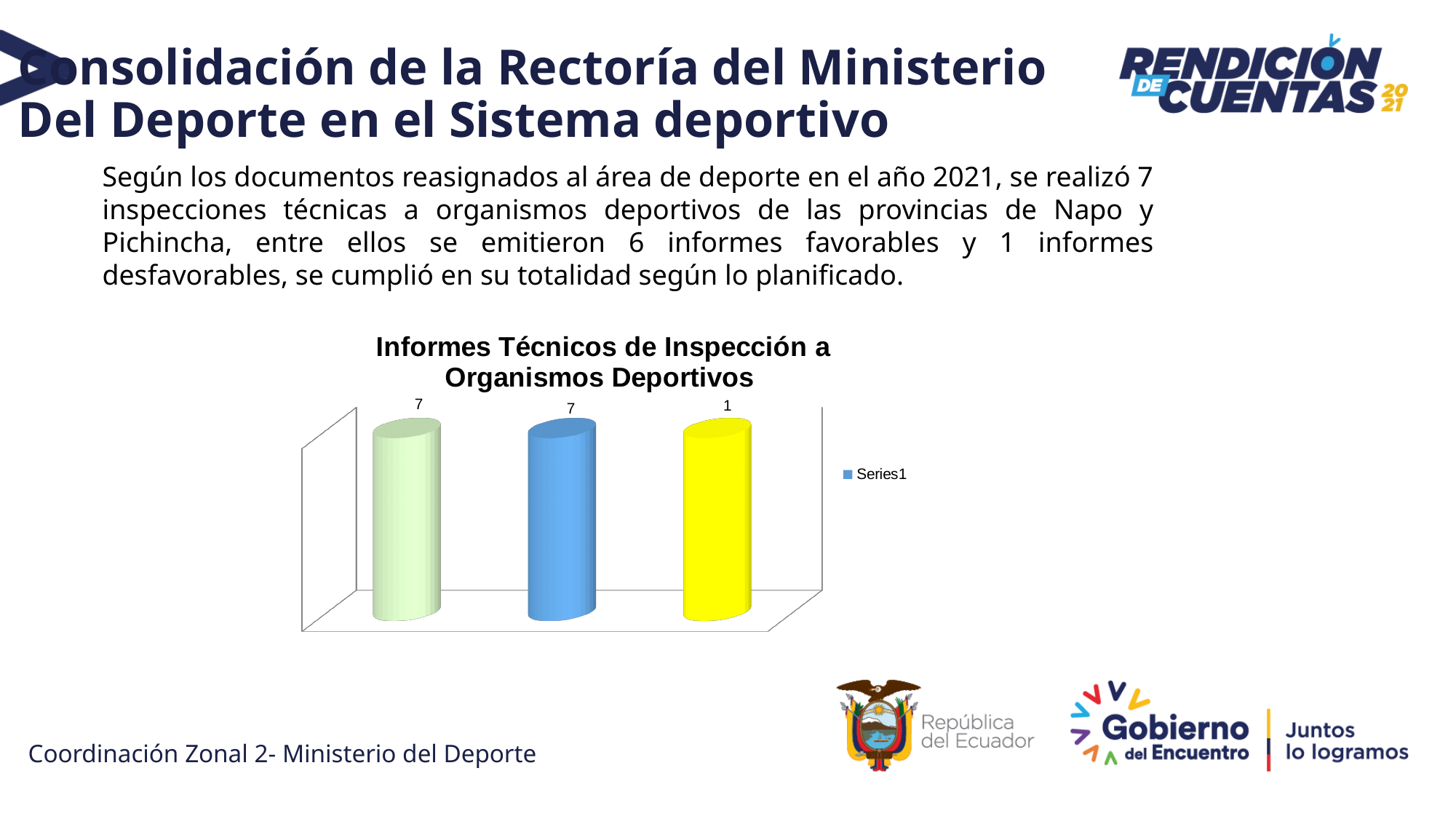
What is the title of the chart? Informes Técnicos de Inspección a Organismos Deportivos How many bars are plotted in the chart? 3 According to the data labels, which bar has the lowest value? the third (yellow) bar What is the difference between the labelled value of the first (light green) bar and the third (yellow) bar? 6 What kind of chart is shown on the slide? bar chart How many series does the chart legend list? 1 What is the name of the series shown in the chart legend? Series1 What value is labelled on the first (light green) bar? 7 According to the data labels, which is larger: the value of the blue bar or the value of the yellow bar? the blue bar Is the labelled value of the first (light green) bar greater or less than 5? greater What value is labelled on the second (blue) bar? 7 What value is labelled on the third (yellow) bar? 1